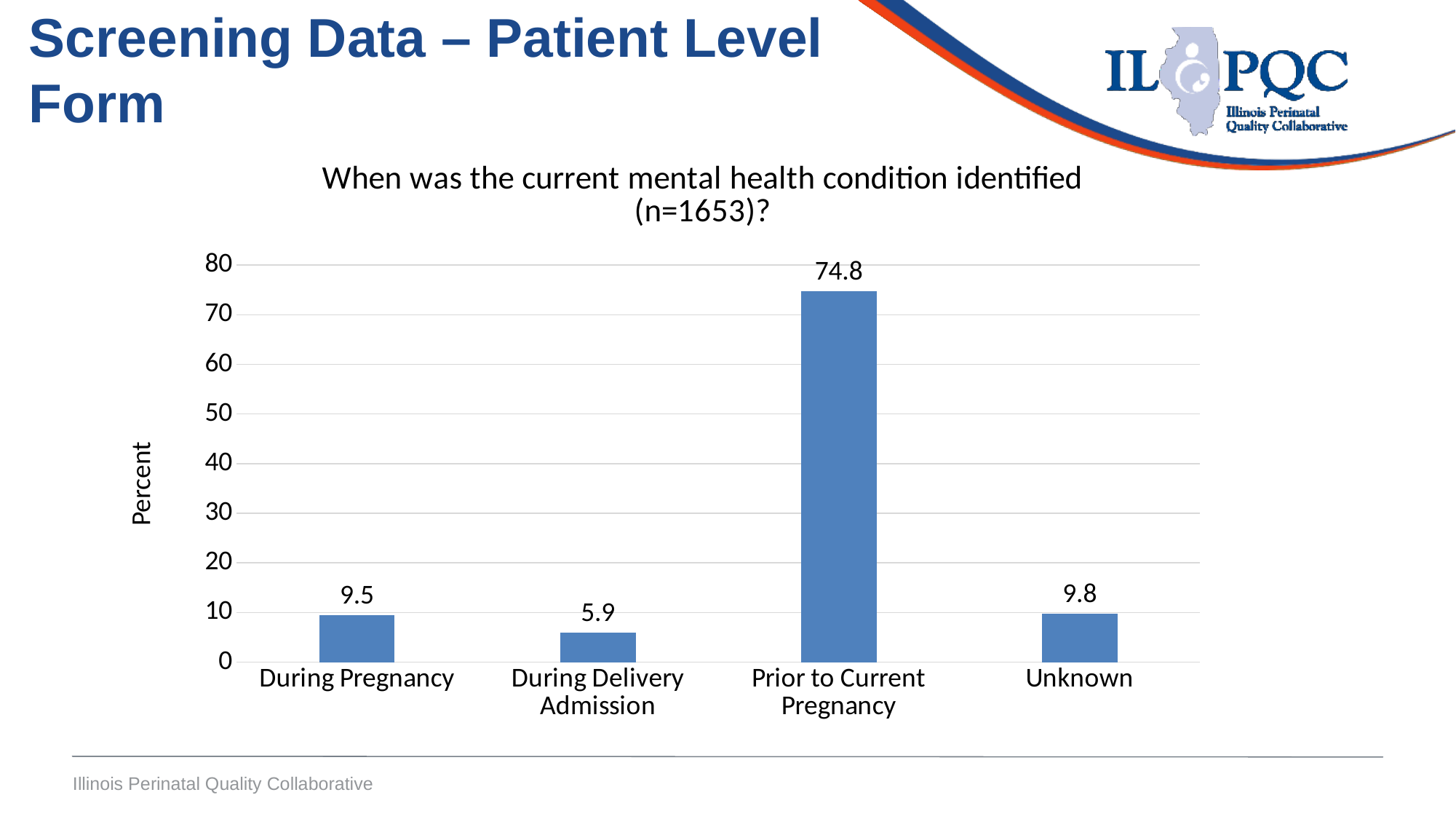
What kind of chart is shown on the slide? bar chart What is the difference between the values for Prior to Current Pregnancy and Unknown? 65.0 Is the value for Prior to Current Pregnancy greater or less than 70? greater What is the value for During Delivery Admission? 5.9 What is the value for Prior to Current Pregnancy? 74.8 What is the value for During Pregnancy? 9.5 What is the value for Unknown? 9.8 Which is larger, the value for Unknown or the value for During Pregnancy? Unknown Which category has the lowest value? During Delivery Admission What is the difference between the values for During Pregnancy and During Delivery Admission? 3.6 Which category has the highest value? Prior to Current Pregnancy How many categories are shown on the x axis? 4